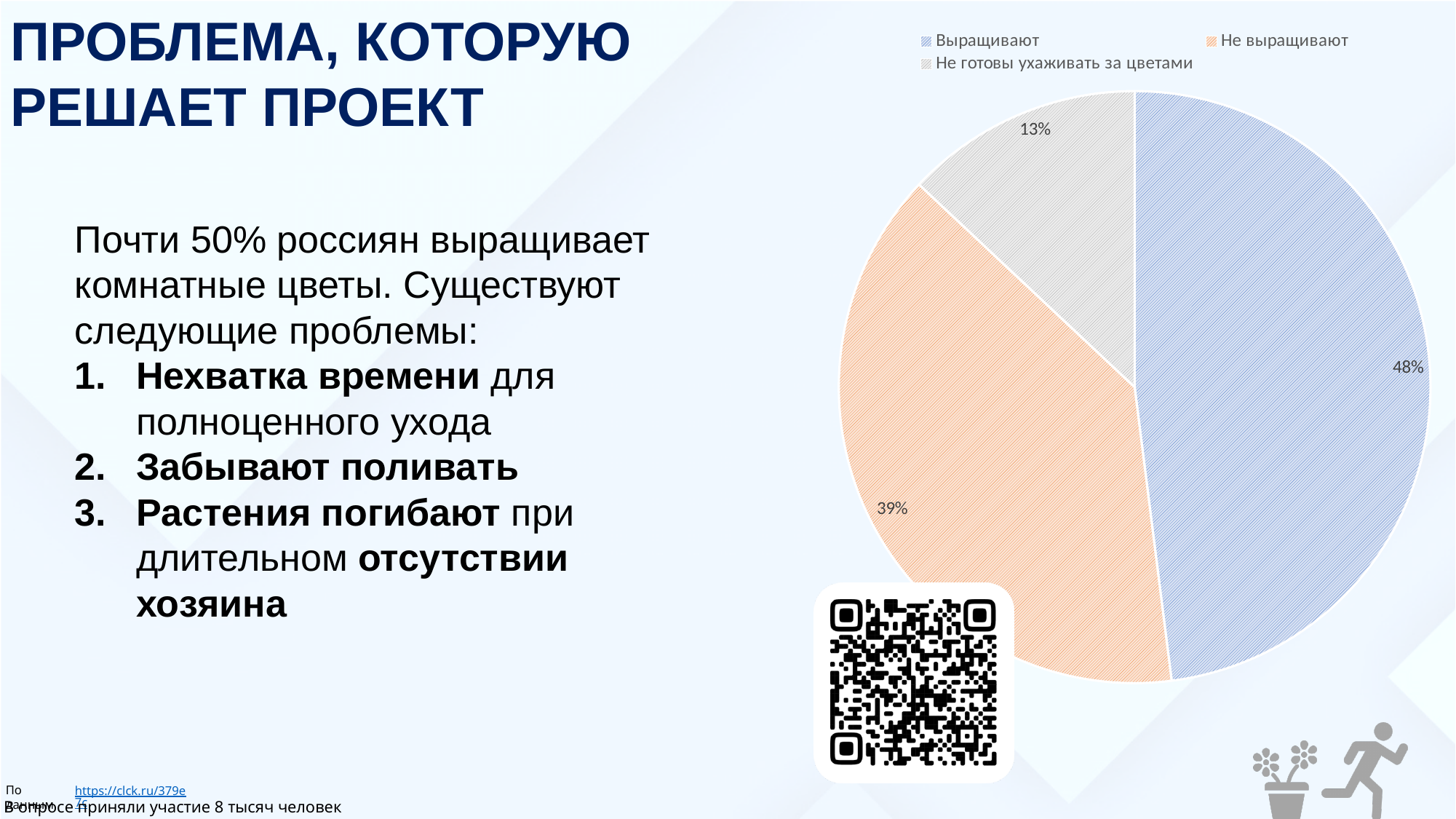
Which slice of the pie chart is the largest? Выращивают Which is larger: the 'Не выращивают' slice or the 'Не готовы ухаживать за цветами' slice? Не выращивают What is the difference in percentage points between the 'Выращивают' and 'Не выращивают' slices? 9 What percentage is shown for the 'Не выращивают' slice? 39% How many entries does the legend list? 3 What percentage is shown for the 'Не готовы ухаживать за цветами' slice? 13% Which legend entry is shown in orange? Не выращивают How many slices does the pie chart have? 3 Which slice of the pie chart is the smallest? Не готовы ухаживать за цветами Which legend entry is shown in blue? Выращивают What type of chart is shown on the slide? pie chart What percentage of the pie is labelled for the 'Выращивают' slice? 48%